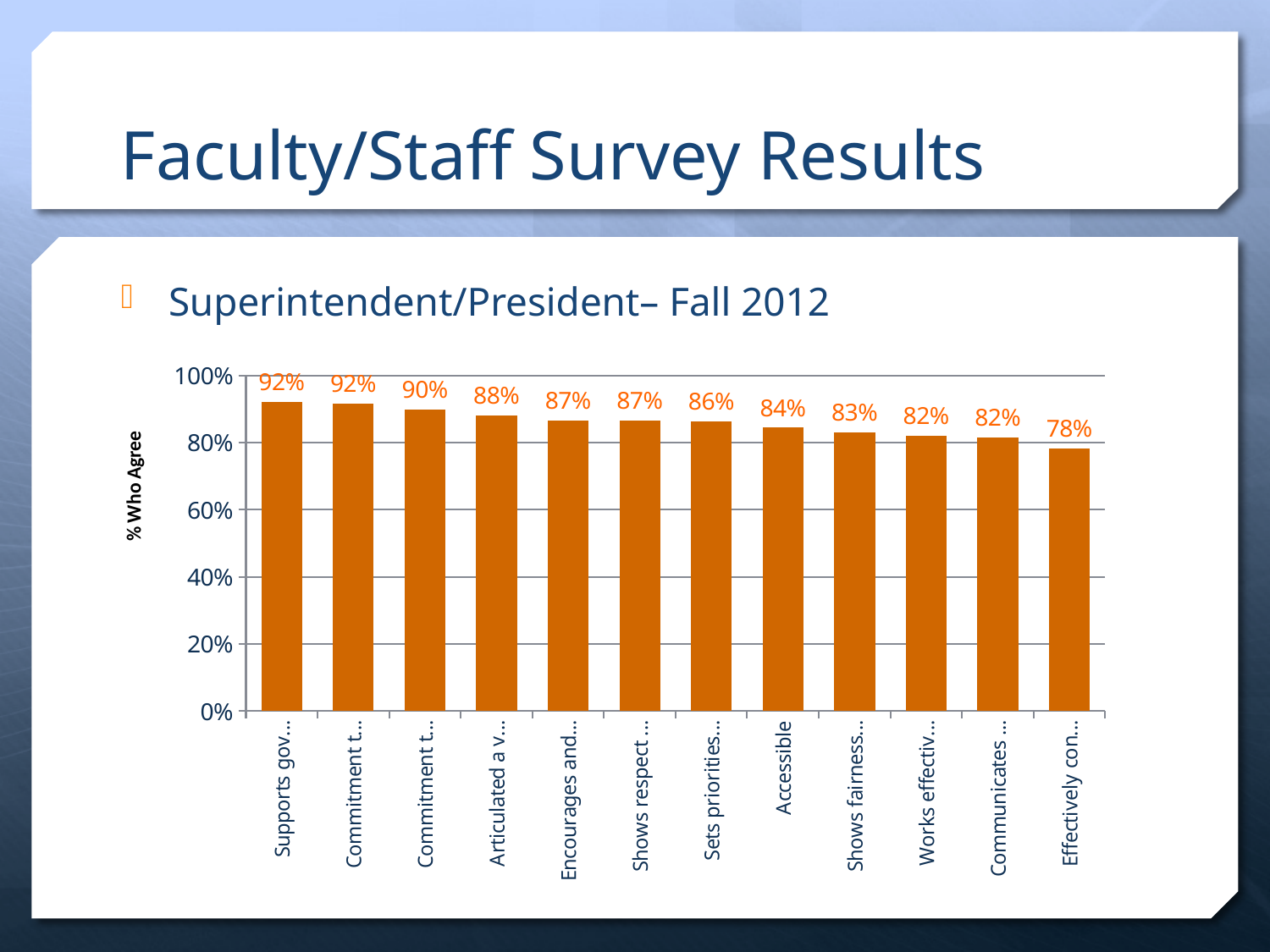
What is the lowest value shown on the chart? 78% What is the value for Accessible? 84% What is the value of the first (leftmost) bar, labelled 'Supports gov...'? 92% What is the title of the vertical axis? % Who Agree Is the value for Accessible greater or less than 80%? greater What is the value of the last (rightmost) bar, labelled 'Effectively con...'? 78% What is the difference between the value for Accessible and the value of the rightmost bar (78%)? 6 percentage points What kind of chart is shown on the slide? bar chart Which is larger, the value for Accessible or the value for 'Shows fairness...'? Accessible What is the highest value shown on the chart? 92% Do the values rise or fall from left to right across the chart? fall How many bars are shown on the chart? 12